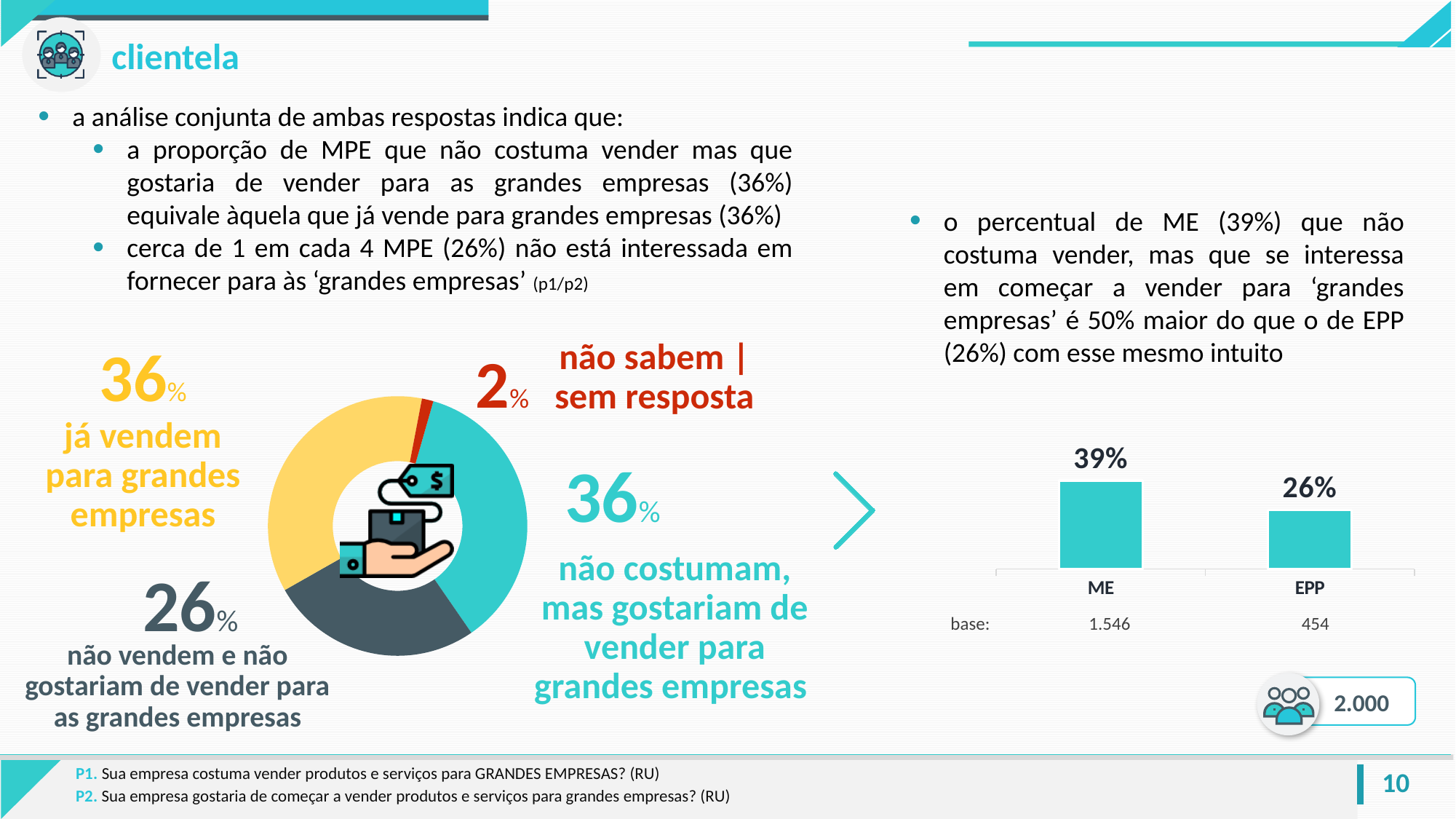
In the donut chart on the left, what percentage do not sell and would not like to sell to large companies ('não vendem e não gostariam de vender')? 26% In the donut chart on the left, what percentage of MPE already sell to large companies ('já vendem para grandes empresas')? 36% In the bar chart on the right, what is the difference between the ME and EPP values? 13% In the donut chart on the left, which segment is the smallest? não sabem | sem resposta In the bar chart on the right, which category has the higher value, ME or EPP? ME In the bar chart on the right, what is the value for ME? 39% In the bar chart on the right, what is the value for EPP? 26% What type of chart is shown on the left of the slide? Donut (pie) chart In the donut chart on the left, what percentage is 'não sabem | sem resposta'? 2% In the donut chart on the left, how many segments are shown? 4 In the donut chart on the left, what is the difference between the 'não vendem e não gostariam de vender' share and the 'não sabem | sem resposta' share? 24% In the bar chart on the right, what is the base (number of respondents) for ME? 1.546